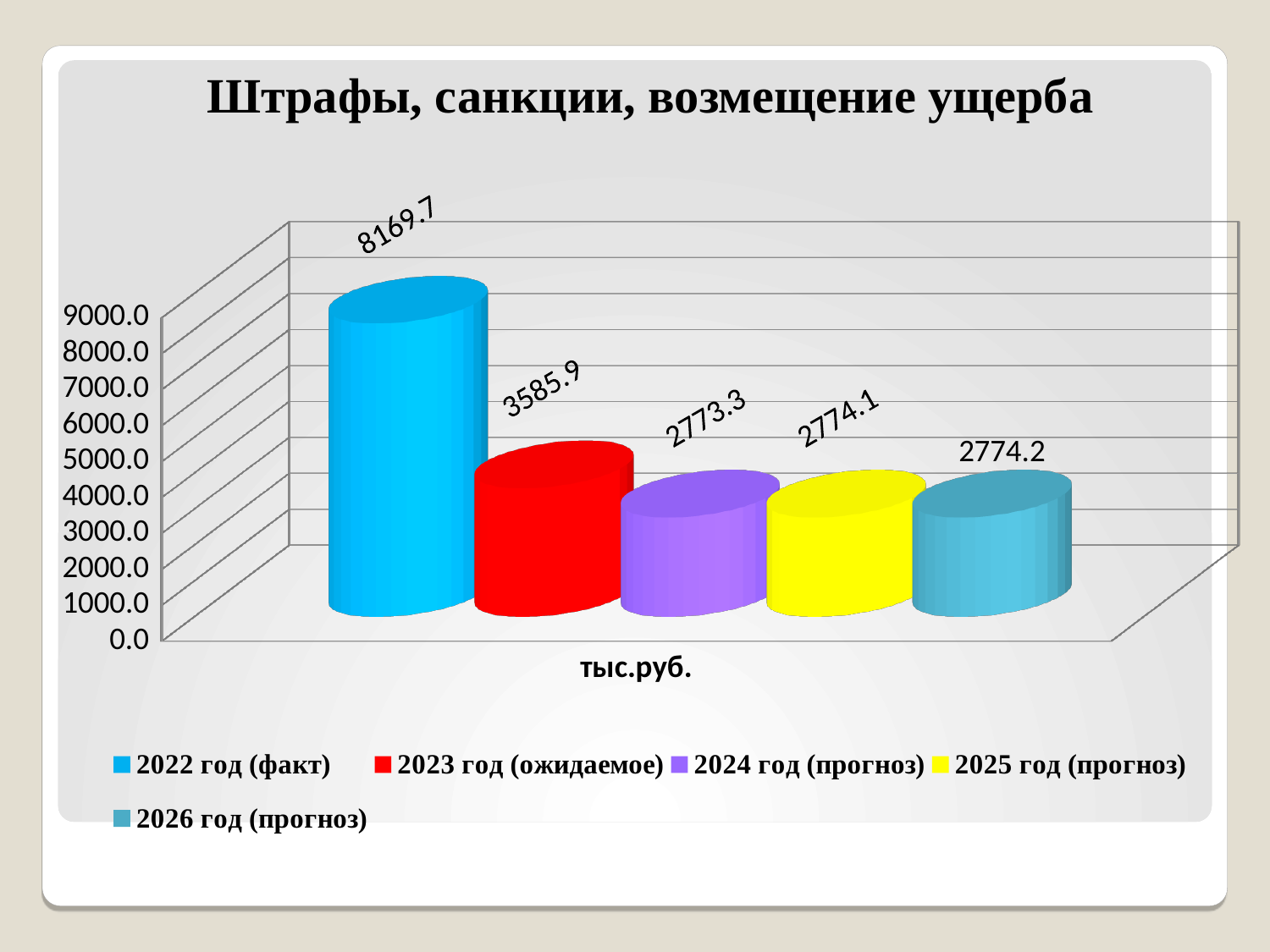
What is the value for 2023 год (ожидаемое)? 3585.9 What is the title of the chart? Штрафы, санкции, возмещение ущерба Which series has the highest value? 2022 год (факт) What is the difference between the values for 2023 год (ожидаемое) and 2024 год (прогноз)? 812.6 What is the value for 2026 год (прогноз)? 2774.2 What is the difference between the values for 2022 год (факт) and 2023 год (ожидаемое)? 4583.8 What is the value for 2024 год (прогноз)? 2773.3 What kind of chart is shown on the slide? Bar chart What is the value for 2022 год (факт)? 8169.7 How many series does the legend list? 5 Which is larger, the value for 2023 год (ожидаемое) or the value for 2026 год (прогноз)? 2023 год (ожидаемое) What is the value for 2025 год (прогноз)? 2774.1